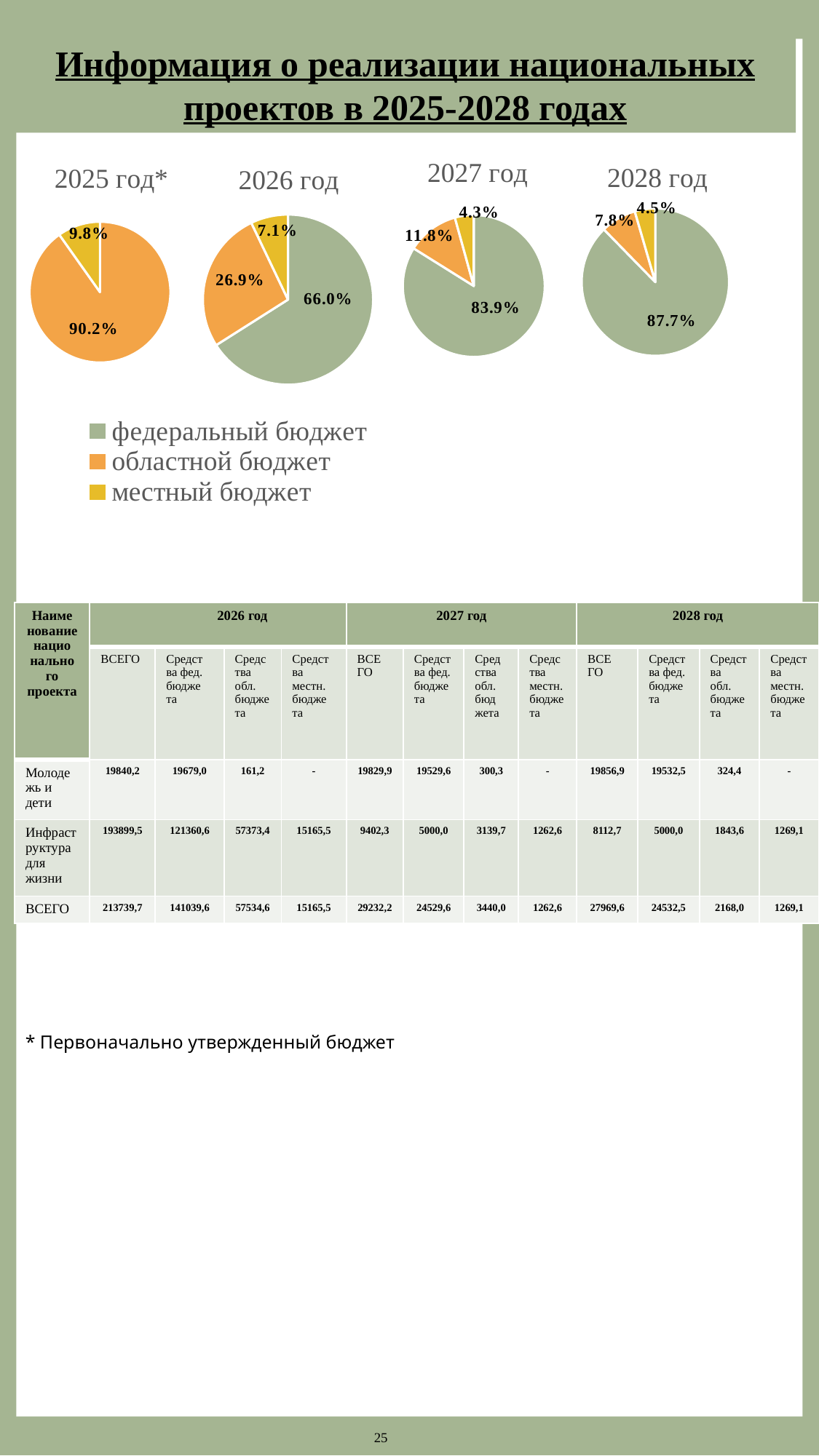
In the 2028 год pie chart, what is the difference between the федеральный бюджет share and the областной бюджет share? 79.9% In the 2025 год* pie chart, what share does областной бюджет have? 90.2% In the 2026 год pie chart, which budget source has the smallest slice? местный бюджет How many pie charts are shown on the slide? 4 What type of chart is used to show the budget shares for each year? pie chart In the 2027 год pie chart, which budget source has the largest slice? федеральный бюджет How many series does the legend list for the pie charts? 3 In the 2028 год pie chart, what share does областной бюджет have? 7.8% Which is larger: the местный бюджет share in the 2025 год* chart or in the 2026 год chart? 2025 год* In the 2026 год pie chart, what share does федеральный бюджет have? 66.0% In the 2026 год pie chart, what is the difference between the областной бюджет share and the местный бюджет share? 19.8%